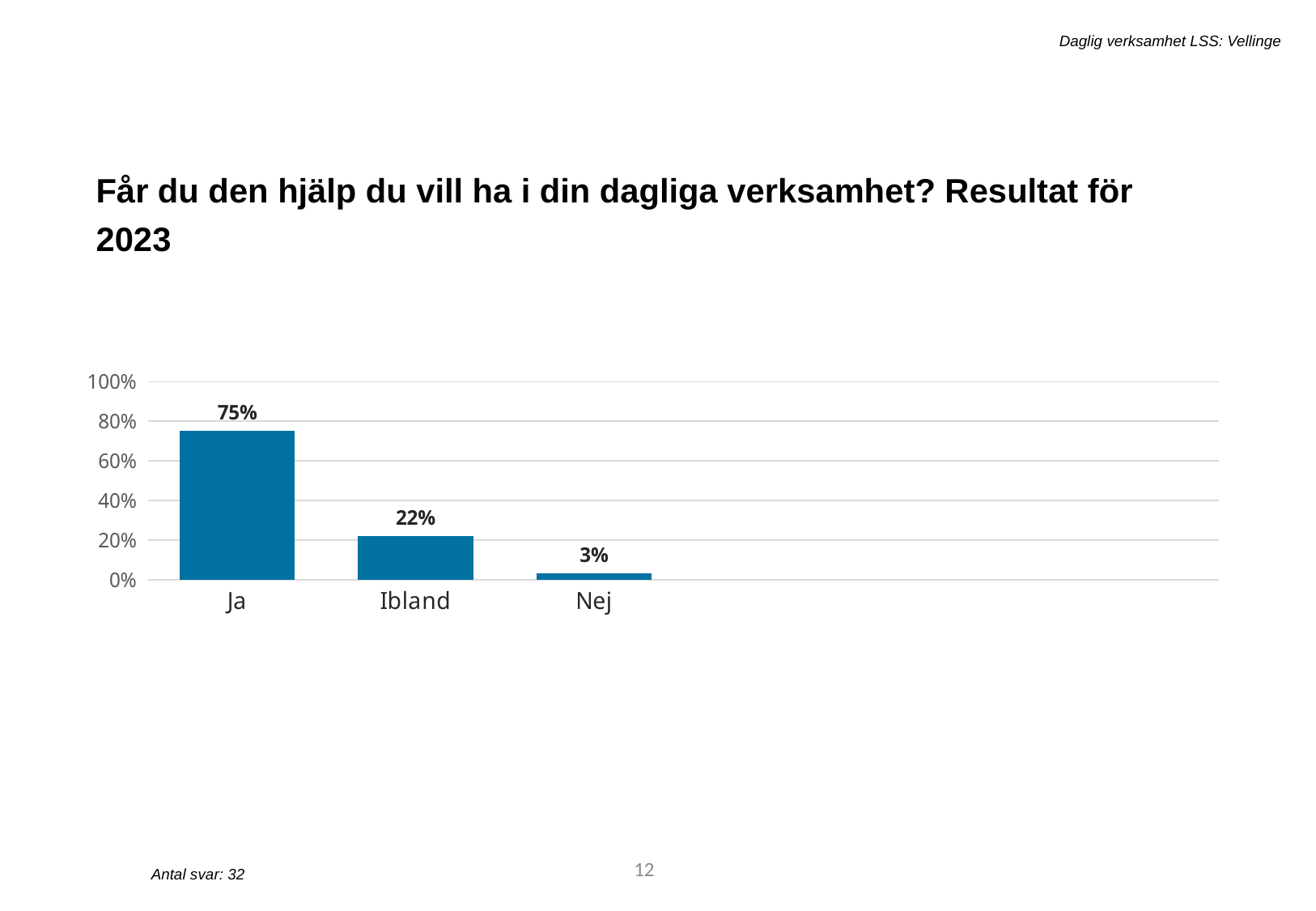
Is the value for Ja greater or less than 60%? greater What is the value for Ibland? 22% What is the difference between the values for Ja and Ibland? 53% What kind of chart is shown on the slide? bar chart What is the value for Ja? 75% How many categories are shown on the x axis? 3 What is the difference between the values for Ibland and Nej? 19% Which category has the highest value? Ja What is the value for Nej? 3% Which category has the lowest value? Nej Which is larger, the value for Ibland or the value for Nej? Ibland Do the values rise or fall from left to right along the x axis? fall